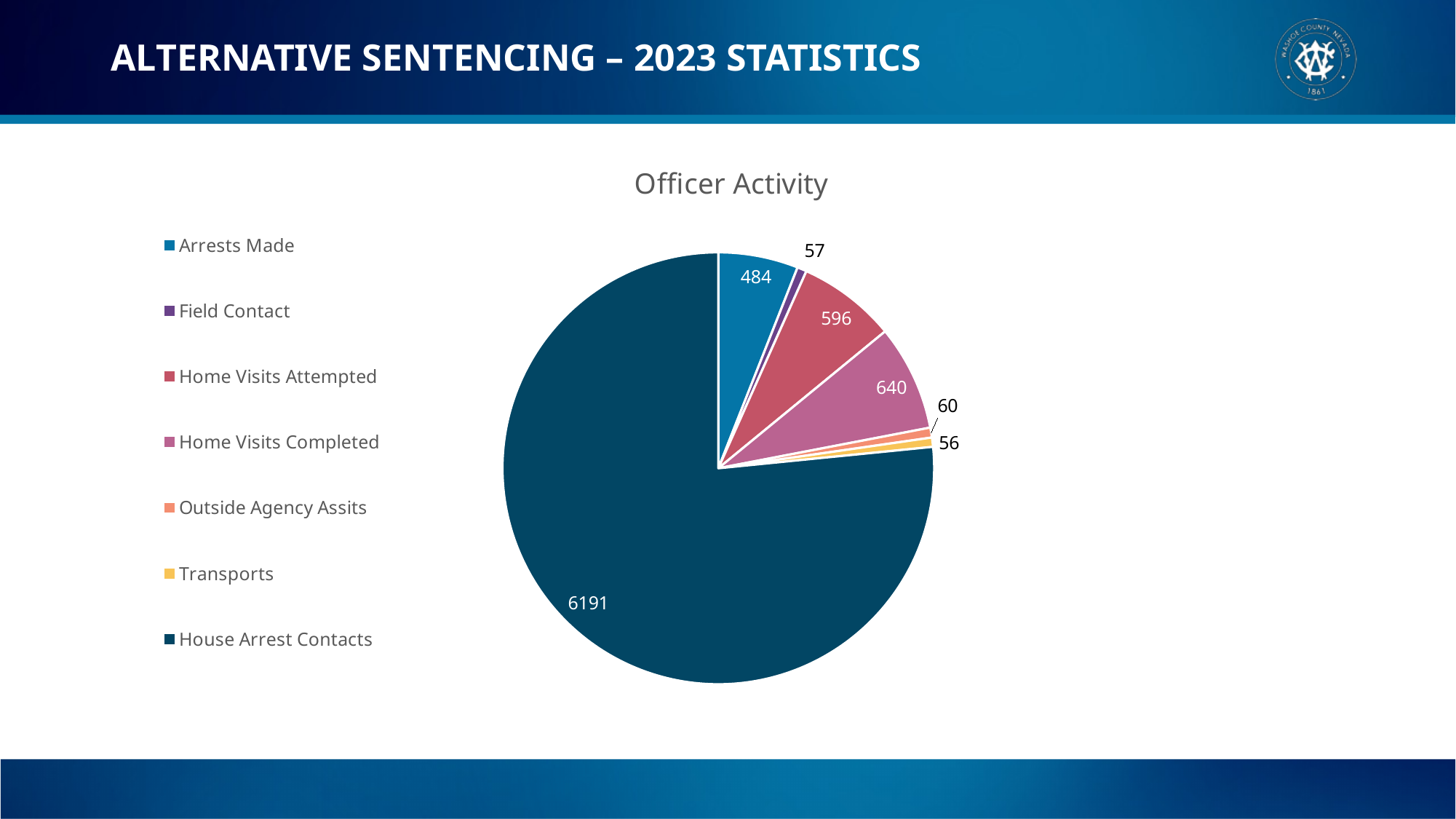
What is the value for Transports? 56 What is the value for House Arrest Contacts? 6191 What is the difference between Home Visits Completed and Home Visits Attempted? 44 What type of chart is shown on the slide? pie chart What is the value for Arrests Made? 484 What is the value for Home Visits Completed? 640 What is the difference between House Arrest Contacts and Arrests Made? 5707 Which is larger, Home Visits Completed or Home Visits Attempted? Home Visits Completed Which category has the largest slice of the pie? House Arrest Contacts What is the value for Home Visits Attempted? 596 What is the title of the chart? Officer Activity How many categories does the legend list? 7